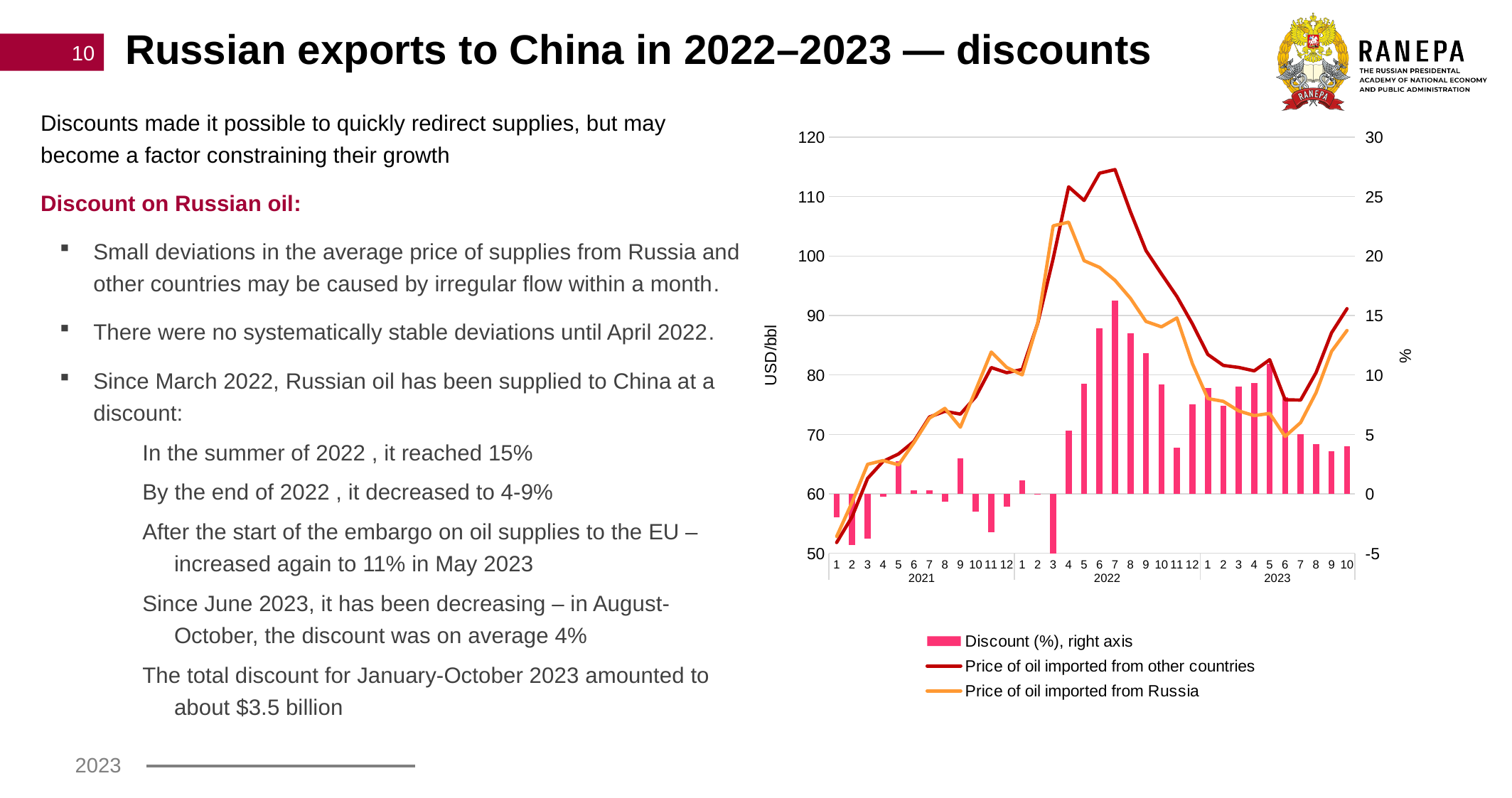
In July 2022, which is higher: the price of oil imported from other countries or the price of oil imported from Russia? Price of oil imported from other countries What kind of chart is shown on the slide? Combined bar and line chart How does the Discount (%) change from July 2022 to December 2022? It falls Is the Discount (%) value for July 2022 greater or less than 15? greater How many years are labelled on the x axis of the chart? 3 Is the price of oil imported from other countries in July 2022 greater or less than 110 USD/bbl? greater In which month is the Discount (%) bar the highest? July 2022 How many series does the chart legend list? 3 Is the price of oil imported from Russia in June 2023 greater or less than 80 USD/bbl? less In which month is the Discount (%) bar the lowest? March 2022 Which series is plotted on the right axis of the chart? Discount (%)